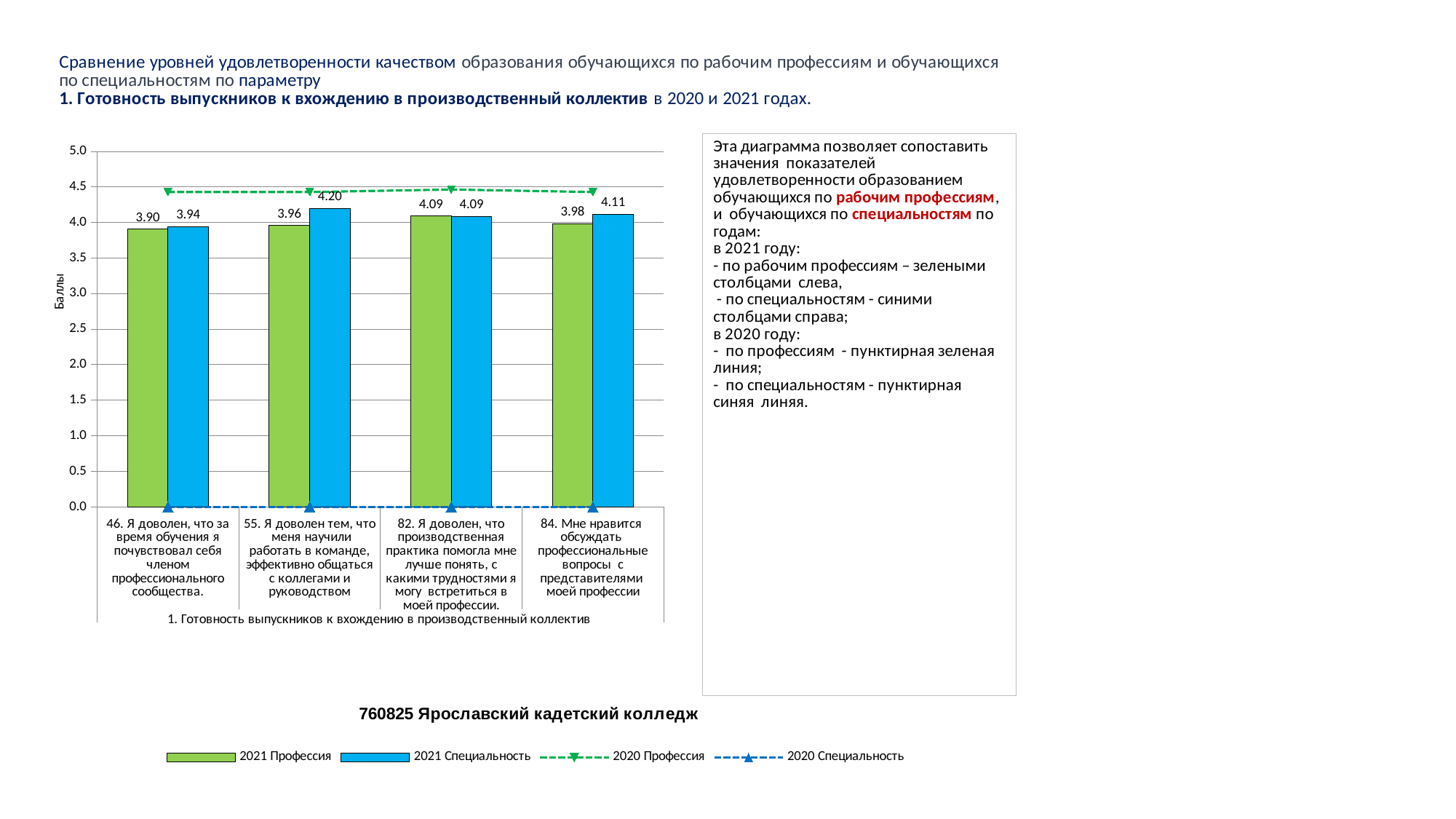
What is the value of the 2021 Специальность bar for category 55 (Я доволен тем, что меня научили работать в команде)? 4.20 Is the 2020 Профессия dashed line value for category 46 greater or less than 4.0? greater What is the value of the 2021 Профессия bar for category 84 (Мне нравится обсуждать профессиональные вопросы с представителями моей профессии)? 3.98 Which category has the lowest 2021 Профессия value? 46. Я доволен, что за время обучения я почувствовал себя членом профессионального сообщества. What is the value of the 2021 Профессия bar for category 46 (Я доволен, что за время обучения я почувствовал себя членом профессионального сообщества)? 3.90 How many series does the chart legend list? 4 Which category has the highest 2021 Специальность value? 55. Я доволен тем, что меня научили работать в команде, эффективно общаться с коллегами и руководством How many categories are shown on the x axis of the chart? 4 For category 84, which is larger: the 2021 Профессия value or the 2021 Специальность value? 2021 Специальность What type of chart is used to show the 2021 values? bar chart What is the label of the y axis of the chart? Баллы What is the difference between the 2021 Специальность and 2021 Профессия values for category 55? 0.24